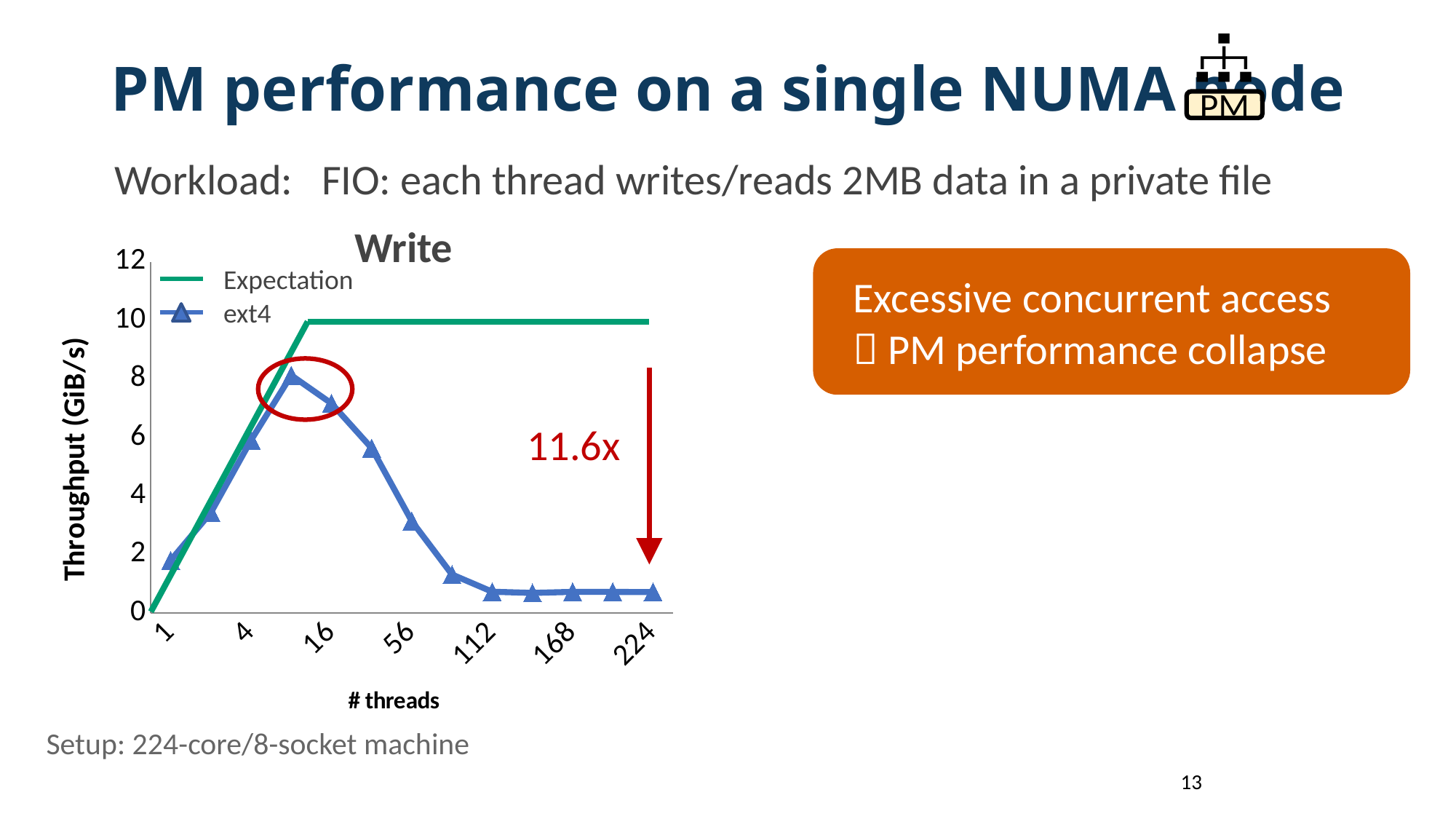
Which series reaches the higher peak throughput on the chart? Expectation Is the ext4 throughput at 112 threads greater or less than 2 GiB/s? less What factor is printed next to the red downward arrow on the chart? 11.6x What are the two series named in the chart's legend? Expectation and ext4 Is the ext4 throughput at 16 threads greater or less than 6 GiB/s? greater Does the ext4 throughput rise or fall as the thread count increases from 16 to 112? fall What kind of chart is shown on the slide? line chart How many series does the chart's legend list? 2 Is the Expectation throughput at 224 threads greater or less than 8 GiB/s? greater At 224 threads, which series has the higher throughput, Expectation or ext4? Expectation How many tick labels are shown on the # threads axis? 7